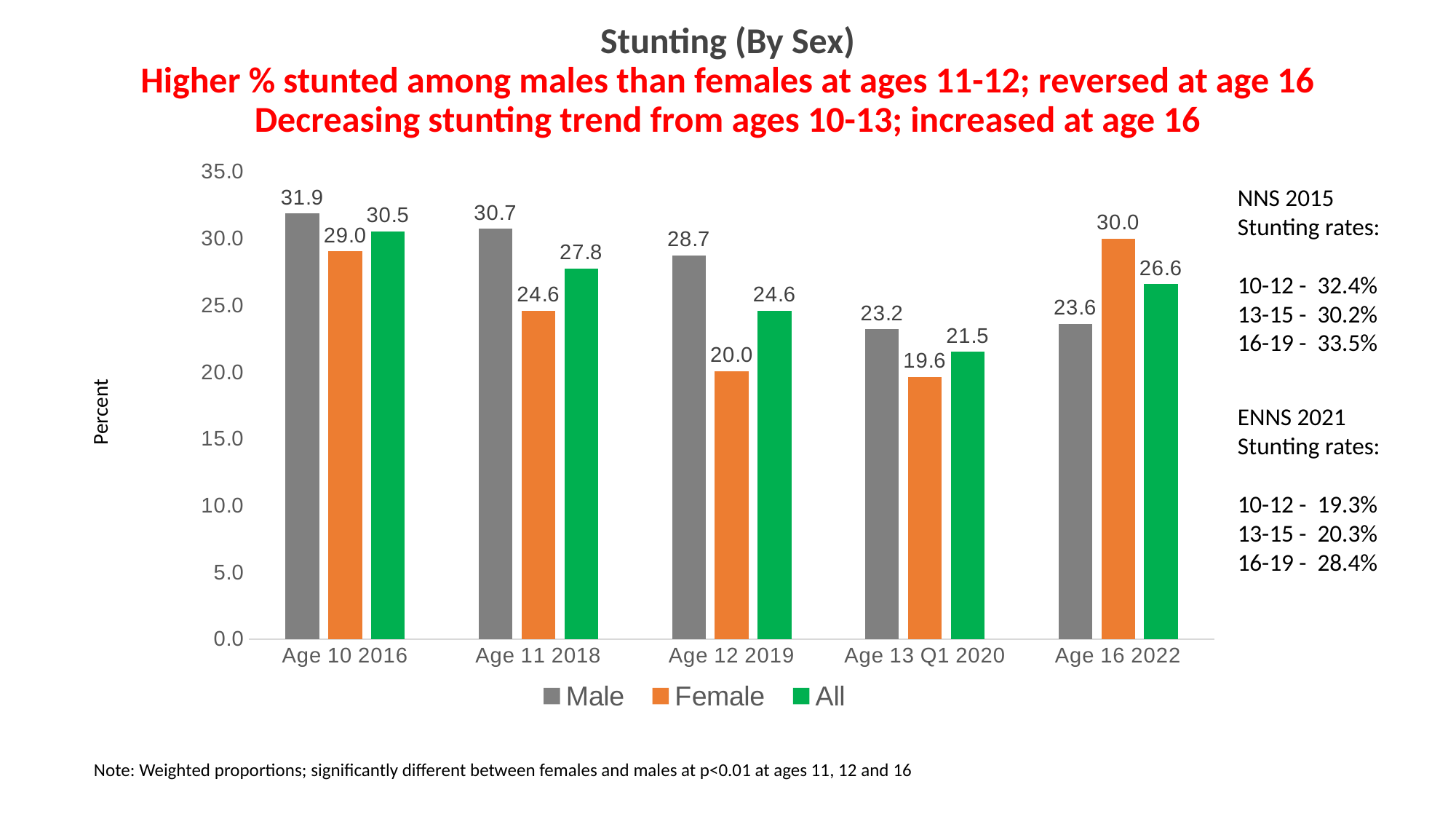
Which age group has the lowest Female value? Age 13 Q1 2020 What is the Male value for Age 10 2016? 31.9 How many age groups are shown on the x axis? 5 Which age group has the highest Male value? Age 10 2016 What is the label on the y axis? Percent What is the Female value for Age 16 2022? 30.0 What kind of chart is shown on the slide? Bar chart What is the All value for Age 13 Q1 2020? 21.5 What is the difference between the Male and Female values for Age 12 2019? 8.7 How many series does the legend list? 3 Which is larger at Age 16 2022, the Male value or the Female value? Female Does the All value rise or fall from Age 10 2016 to Age 13 Q1 2020? Fall